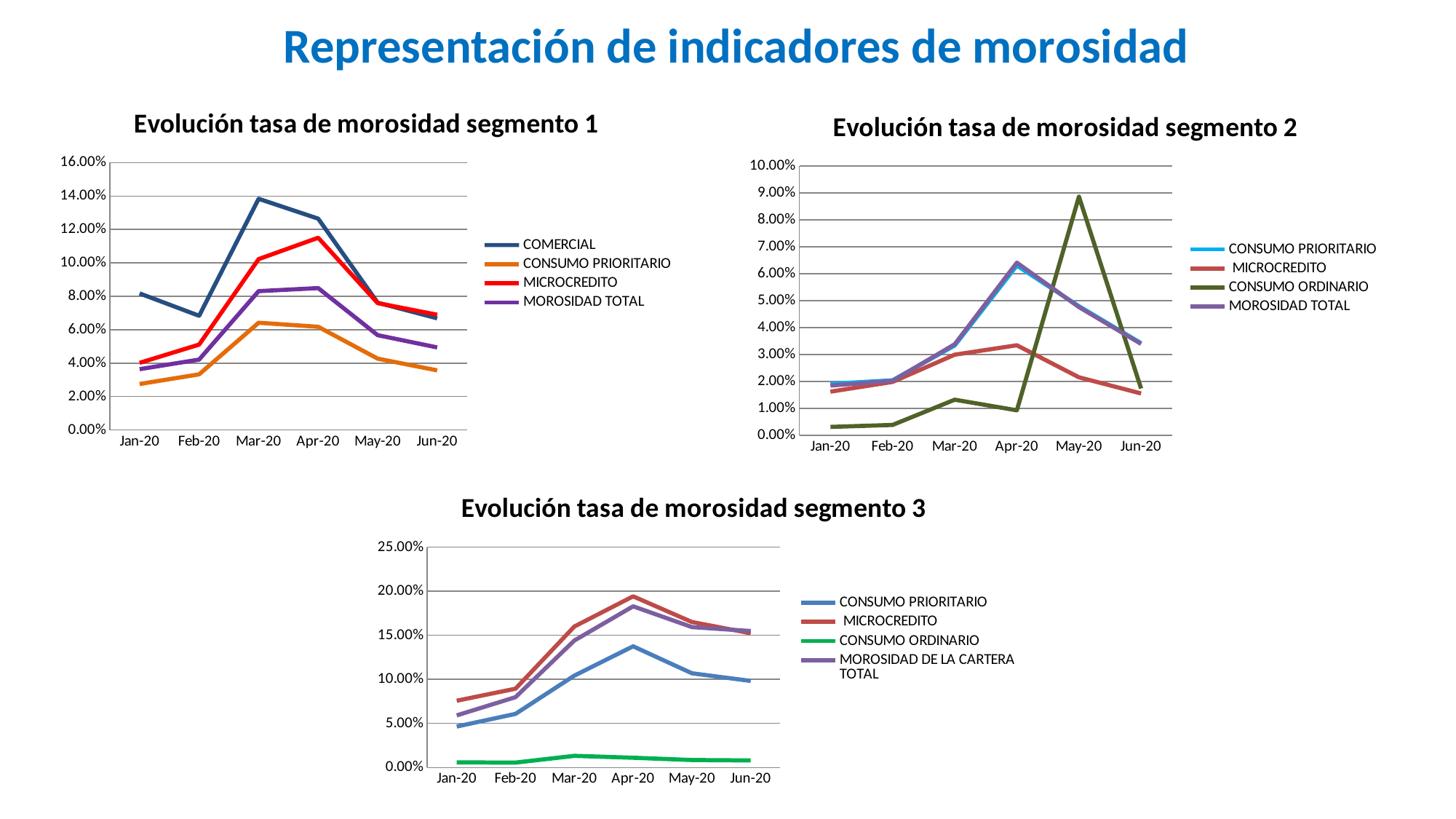
How many series does the legend of 'Evolución tasa de morosidad segmento 1' list? 4 In 'Evolución tasa de morosidad segmento 1', which series has the lowest value in Jun-20? CONSUMO PRIORITARIO In 'Evolución tasa de morosidad segmento 1', which series has the highest value in Mar-20? COMERCIAL In 'Evolución tasa de morosidad segmento 1', is the value for COMERCIAL in Mar-20 greater or less than 12.00%? greater In 'Evolución tasa de morosidad segmento 3', which series is shown in green? CONSUMO ORDINARIO In 'Evolución tasa de morosidad segmento 2', is the value for CONSUMO ORDINARIO in May-20 greater or less than 8.00%? greater In 'Evolución tasa de morosidad segmento 2', in which month does CONSUMO ORDINARIO reach its highest value? May-20 In 'Evolución tasa de morosidad segmento 3', does the CONSUMO PRIORITARIO line rise or fall from Apr-20 to Jun-20? fall What kind of chart is 'Evolución tasa de morosidad segmento 1'? Line chart In 'Evolución tasa de morosidad segmento 3', is the value for MICROCREDITO in Apr-20 greater or less than 15.00%? greater In 'Evolución tasa de morosidad segmento 2', which series has the lowest value in Jan-20? CONSUMO ORDINARIO How many months are shown on the x axis of 'Evolución tasa de morosidad segmento 3'? 6